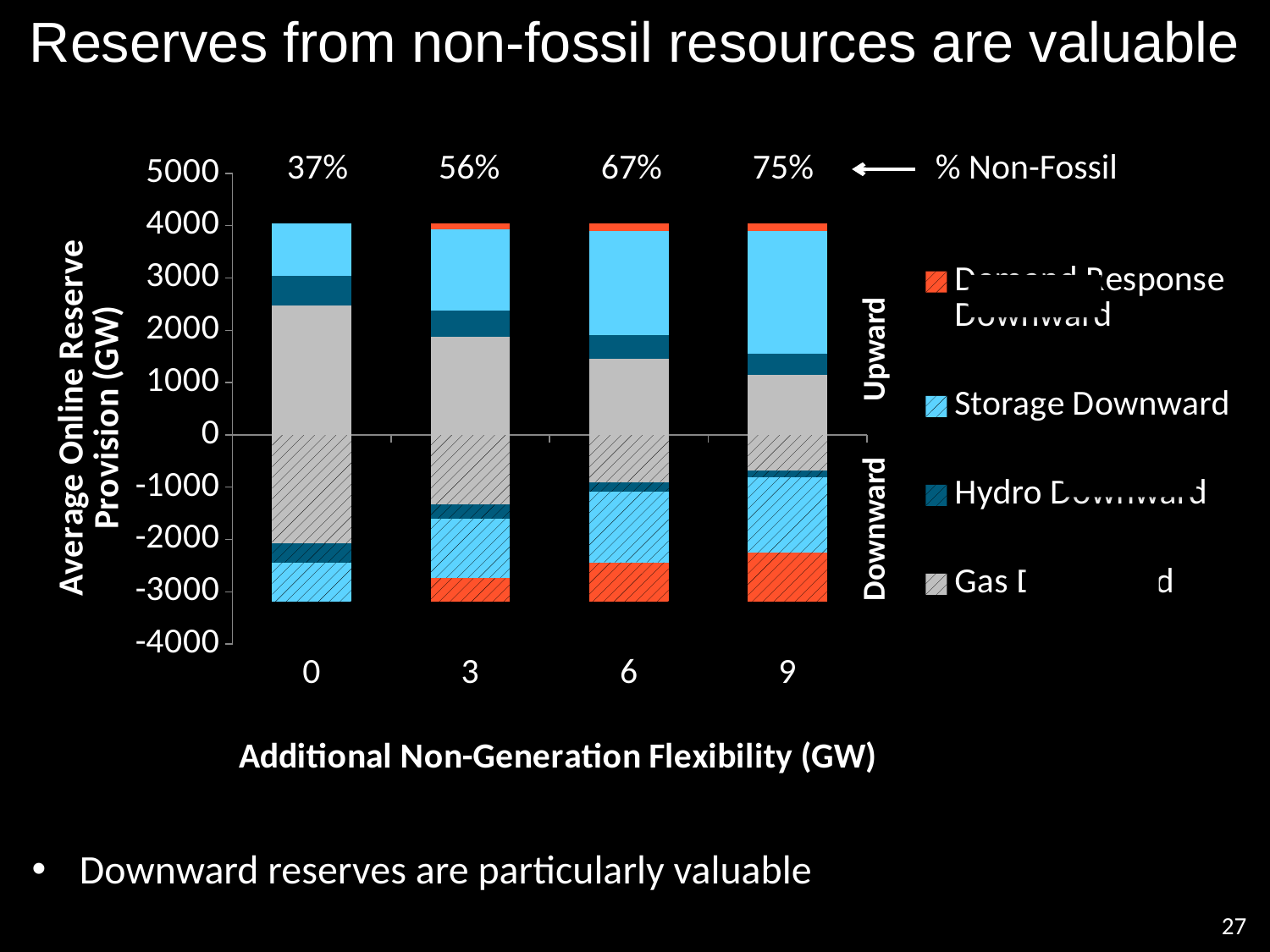
What is the % Non-Fossil value shown above the bar for 0 GW of additional non-generation flexibility? 37% Which has the larger upward gas reserve segment (grey, above zero): 0 GW or 9 GW of additional flexibility? 0 GW What kind of chart is shown on the slide? stacked bar chart What is the title of the x axis of the chart? Additional Non-Generation Flexibility (GW) What is the % Non-Fossil value shown above the bar for 6 GW of additional non-generation flexibility? 67% What is the % Non-Fossil value shown above the bar for 9 GW of additional non-generation flexibility? 75% Is the upward gas reserve segment (grey, above zero) for 9 GW of additional flexibility greater or less than 2000? less What is the difference between the % Non-Fossil values at 9 GW and 0 GW of additional flexibility? 38% Is the upward gas reserve segment (grey, above zero) for 0 GW of additional flexibility greater or less than 2000? greater Which flexibility level has the highest % Non-Fossil value? 9 Does the % Non-Fossil value rise or fall as additional non-generation flexibility increases along the x axis? rises How many flexibility levels (categories) are plotted along the x axis? 4